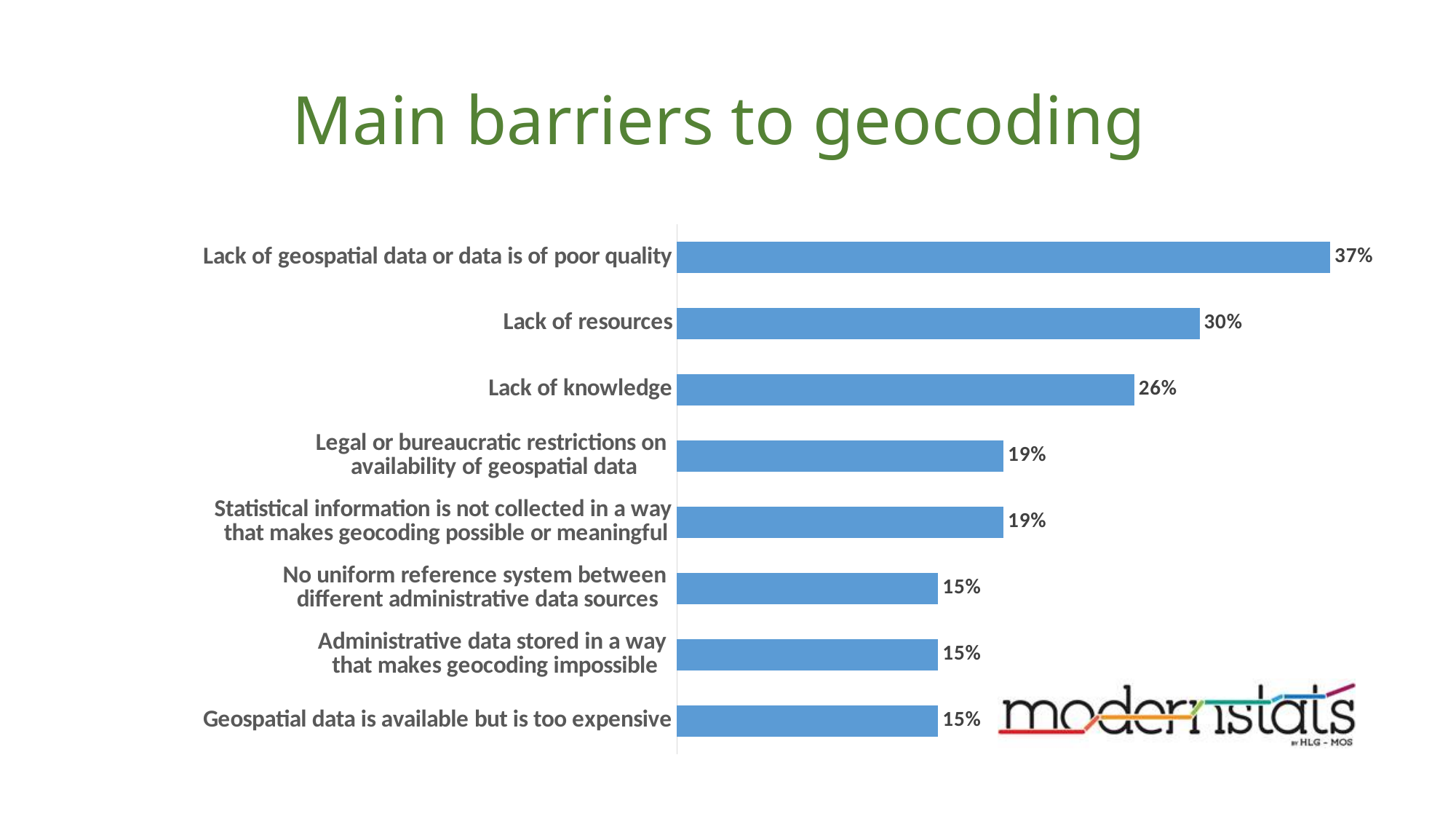
What is the value for "Legal or bureaucratic restrictions on availability of geospatial data"? 19% What percentage is shown for "Lack of geospatial data or data is of poor quality"? 37% What is the difference between the highest value and the value for "Lack of resources"? 7% What percentage is shown for "Lack of knowledge"? 26% Which is larger: the value for "Lack of knowledge" or the value for "No uniform reference system between different administrative data sources"? Lack of knowledge What is the difference between the values for "Lack of resources" and "Lack of knowledge"? 4% What is the value for "Lack of resources"? 30% Which barrier has the highest percentage? Lack of geospatial data or data is of poor quality How many barriers are listed in the chart? 8 What kind of chart is shown on the slide? Bar chart What is the title of the slide? Main barriers to geocoding What percentage is shown for "Geospatial data is available but is too expensive"? 15%